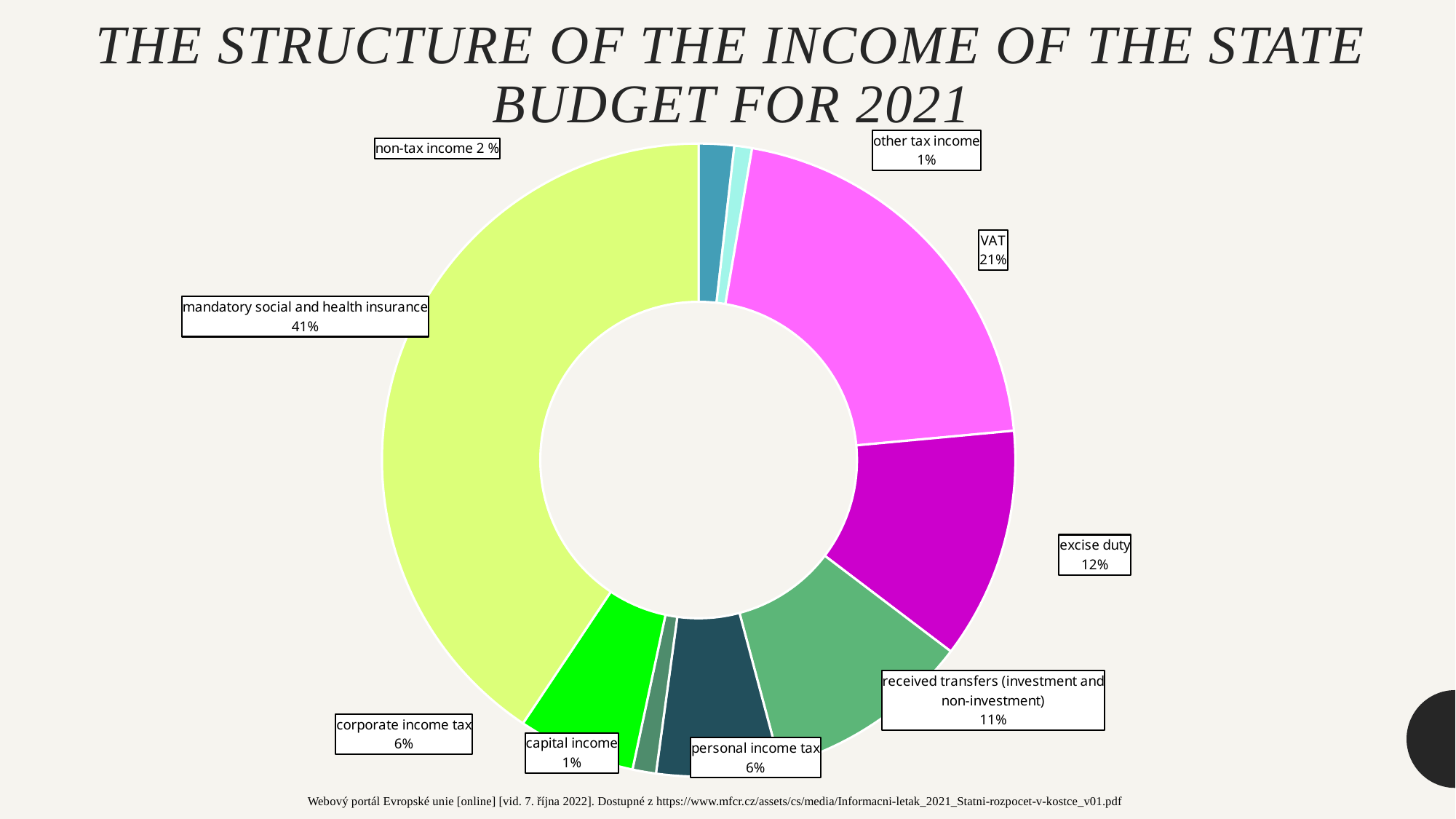
What is the difference in percentage points between mandatory social and health insurance and VAT? 20 How many categories are shown in the chart? 9 What percentage is shown for received transfers (investment and non-investment)? 11% Which category has the largest share of the state budget income? mandatory social and health insurance Which is larger, the share of VAT or the share of excise duty? VAT What share of the state budget income comes from mandatory social and health insurance? 41% What is the title of the slide? THE STRUCTURE OF THE INCOME OF THE STATE BUDGET FOR 2021 What kind of chart is shown on the slide? pie (doughnut) chart What share does excise duty account for? 12% What share of the income is non-tax income? 2 % What percentage of the income is VAT? 21% What is the difference in percentage points between VAT and excise duty? 9